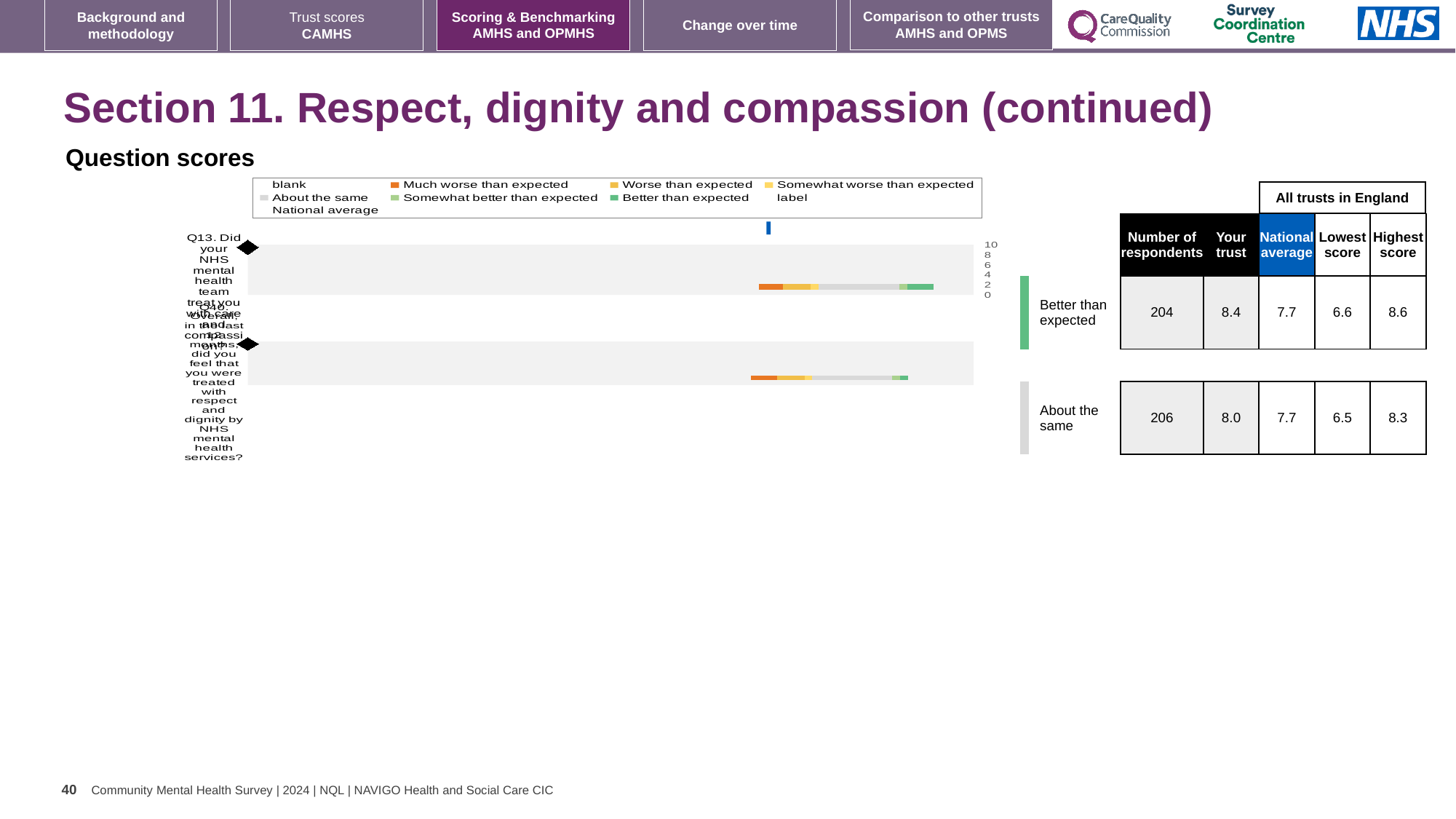
What kind of chart is shown under 'Question scores'? bar chart What is the 'Your trust' score for Q13 (the row rated 'Better than expected')? 8.4 What colour does the legend use for 'Better than expected'? green What is the difference between the highest and lowest scores for Q10? 1.8 What is the national average score for Q13? 7.7 What is the highest score among all trusts in England for Q13? 8.6 What is the lowest score among all trusts in England for Q10? 6.5 How many respondents answered Q10 (the 'About the same' row)? 206 What is the difference between the 'Your trust' scores for Q13 and Q10? 0.4 What is the 'Your trust' score for Q10 (the row rated 'About the same')? 8.0 Which question has the higher 'Your trust' score, Q13 or Q10? Q13 How many questions (categories) are plotted in the chart? 2